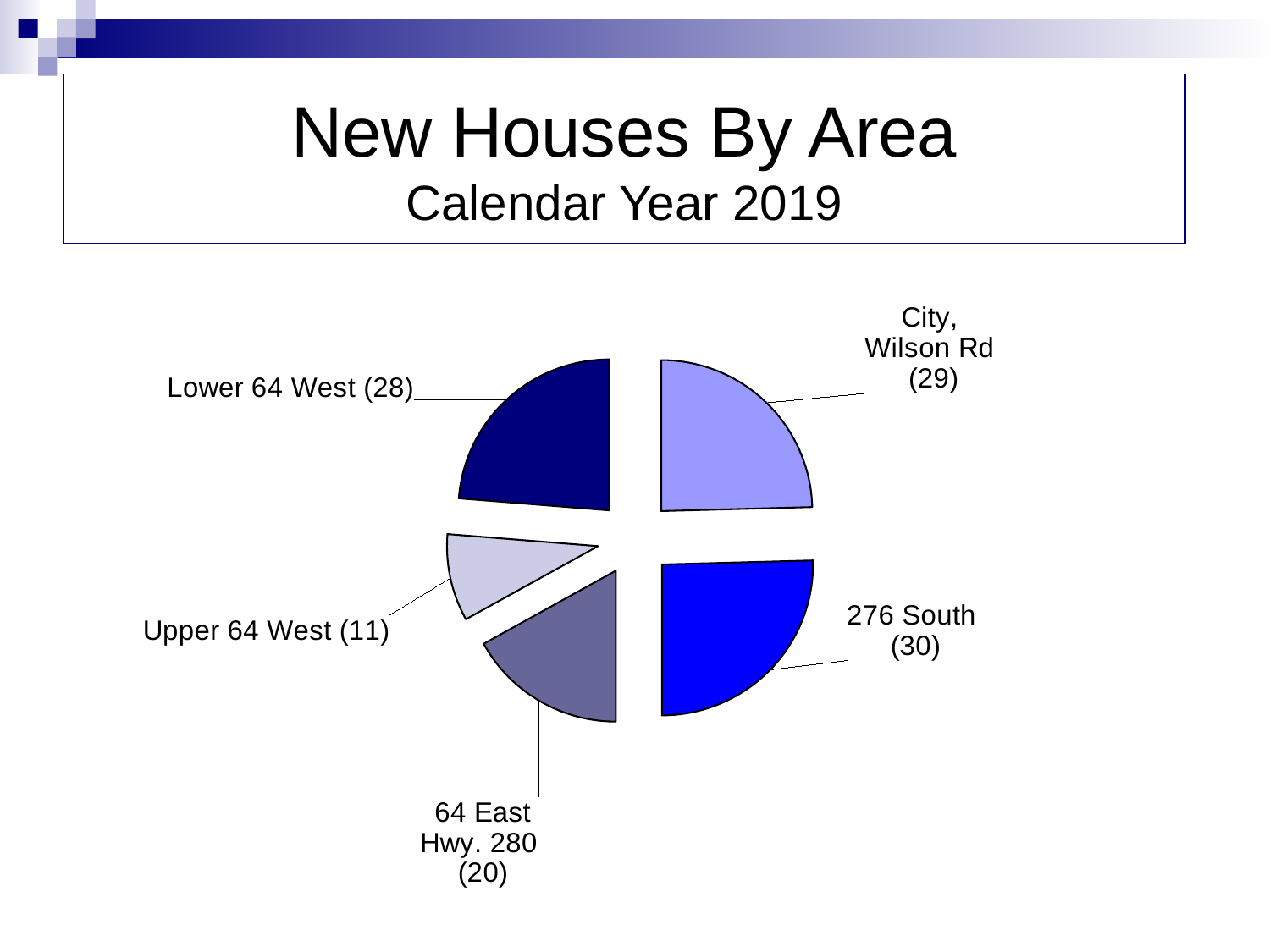
Which area had the most new houses? 276 South Which area had more new houses, 64 East Hwy. 280 or Lower 64 West? Lower 64 West How many areas are shown in the pie chart? 5 How many new houses were built in the City, Wilson Rd area? 29 How many new houses were built in the 64 East Hwy. 280 area? 20 What is the title of the chart? New Houses By Area Calendar Year 2019 What type of chart is shown on the slide? Pie chart How many new houses were built in the 276 South area? 30 Which area had the fewest new houses? Upper 64 West How many more new houses were built in Lower 64 West than in Upper 64 West? 17 How many new houses were built in the Upper 64 West area? 11 What is the total number of new houses across all areas shown? 118